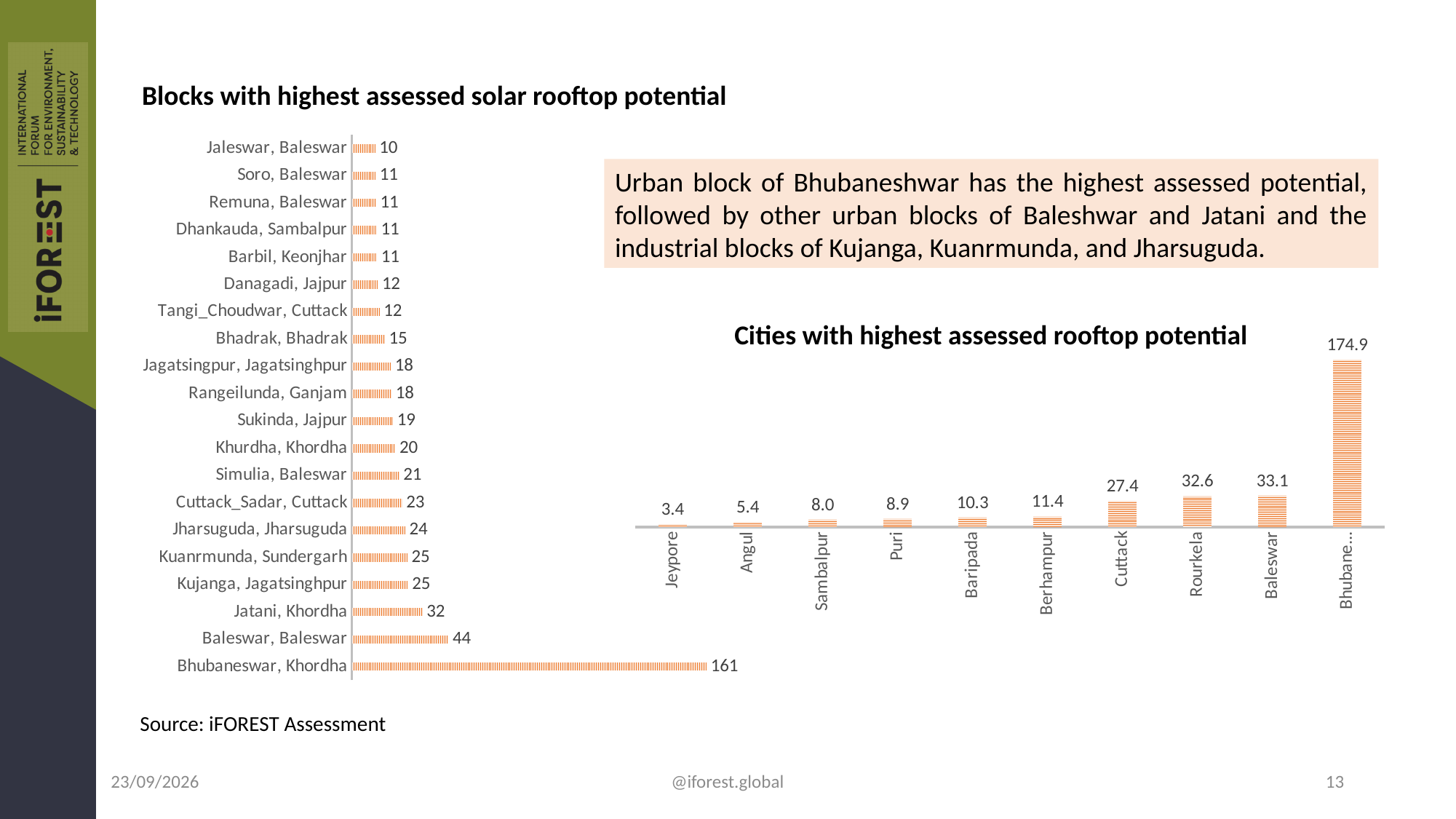
In the 'Blocks with highest assessed solar rooftop potential' chart, what is the value for Jatani, Khordha? 32 In the 'Blocks with highest assessed solar rooftop potential' chart, what is the difference between Baleswar, Baleswar and Jatani, Khordha? 12 In the 'Cities with highest assessed rooftop potential' chart, what is the value for Jeypore? 3.4 In the 'Cities with highest assessed rooftop potential' chart, which is larger, Cuttack or Berhampur? Cuttack In the 'Cities with highest assessed rooftop potential' chart, what is the value for Rourkela? 32.6 In the 'Blocks with highest assessed solar rooftop potential' chart, how many blocks are shown? 20 In the 'Cities with highest assessed rooftop potential' chart, what is the difference between Baleswar and Rourkela? 0.5 What type of chart is the 'Blocks with highest assessed solar rooftop potential' chart? Bar chart In the 'Blocks with highest assessed solar rooftop potential' chart, which block has the lowest value? Jaleswar, Baleswar In the 'Cities with highest assessed rooftop potential' chart, do the values rise or fall from left to right? Rise In the 'Cities with highest assessed rooftop potential' chart, which city has the lowest value? Jeypore In the 'Blocks with highest assessed solar rooftop potential' chart, what is the value for Bhubaneswar, Khordha? 161